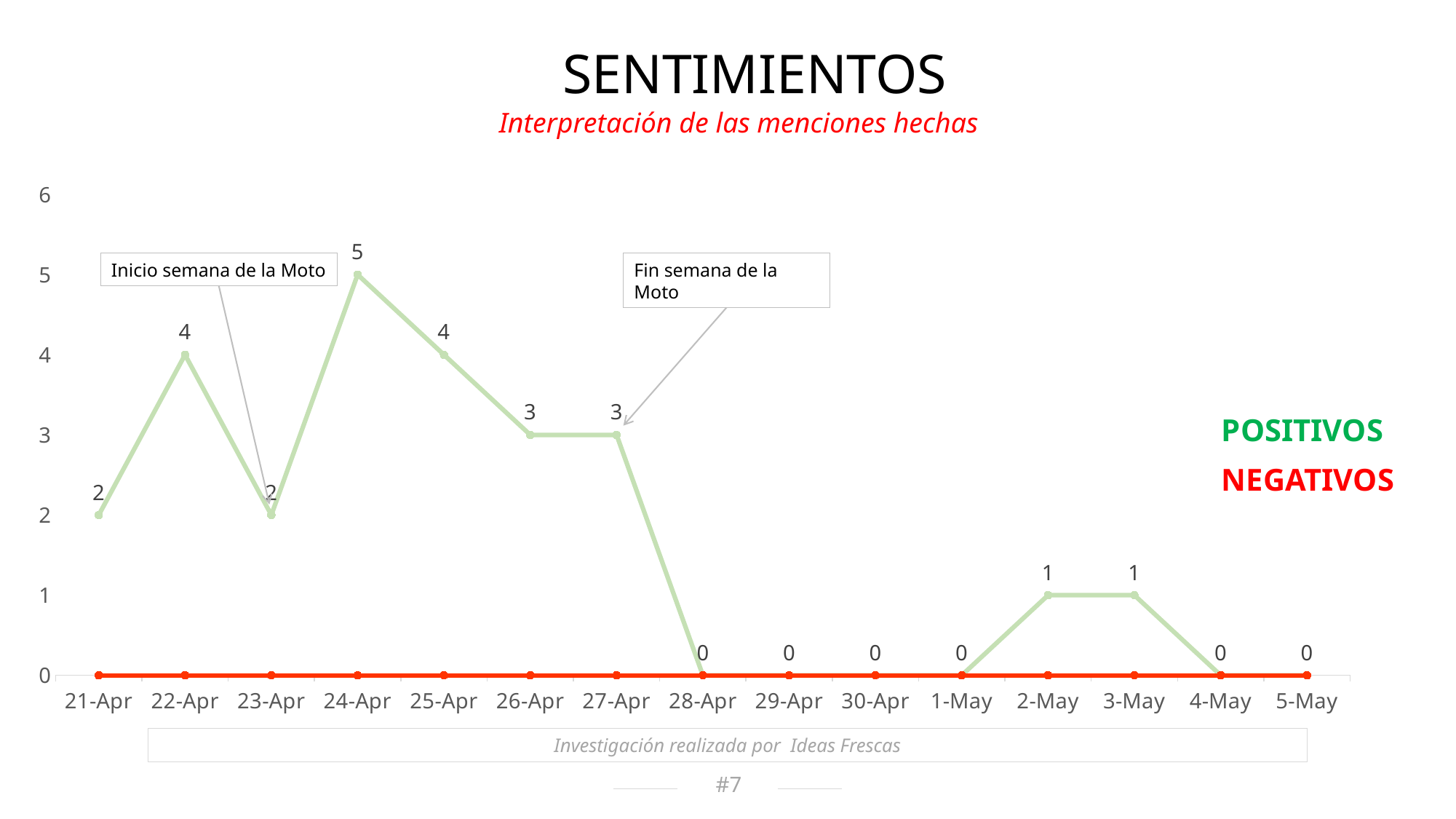
Which is larger, the POSITIVOS value on 25-Apr or on 26-Apr? 25-Apr What is the POSITIVOS value on 27-Apr? 3 What is the POSITIVOS value on 2-May? 1 Does the POSITIVOS series rise or fall from 24-Apr to 28-Apr? fall How many dates are shown on the x axis? 15 What is the title of the chart? SENTIMIENTOS What is the difference between the POSITIVOS values on 24-Apr and 23-Apr? 3 What is the POSITIVOS value on 24-Apr? 5 What is the POSITIVOS value on 22-Apr? 4 What type of chart is shown on the slide? line chart How many series does the chart show? 2 On which date does the POSITIVOS series reach its highest value? 24-Apr